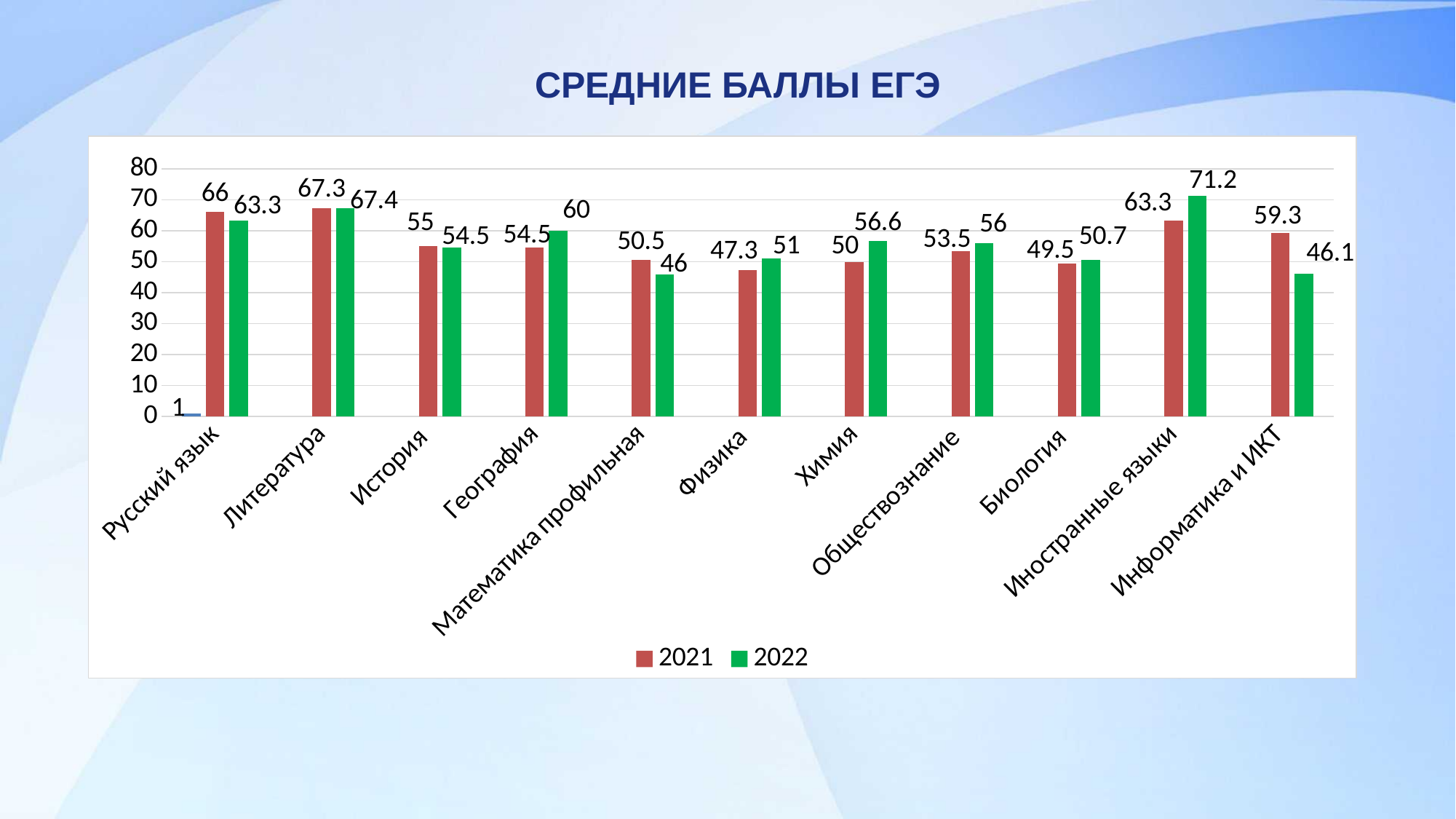
What type of chart is shown on the slide? Bar chart What is the difference between the 2021 and 2022 average scores for Информатика и ИКТ? 13.2 Which year had the higher average score for Физика, 2021 or 2022? 2022 What was the average score for География in 2022? 60 What was the average score for Химия in 2022? 56.6 How many subjects are shown on the x axis of the chart? 11 Which subject had the highest average score in 2022? Иностранные языки How many series does the legend list? 2 Which subject had the lowest average score in 2021? Физика Which year had the higher average score for Математика профильная, 2021 or 2022? 2021 What was the average score for Информатика и ИКТ in 2021? 59.3 By how much did the average score for Иностранные языки increase from 2021 to 2022? 7.9